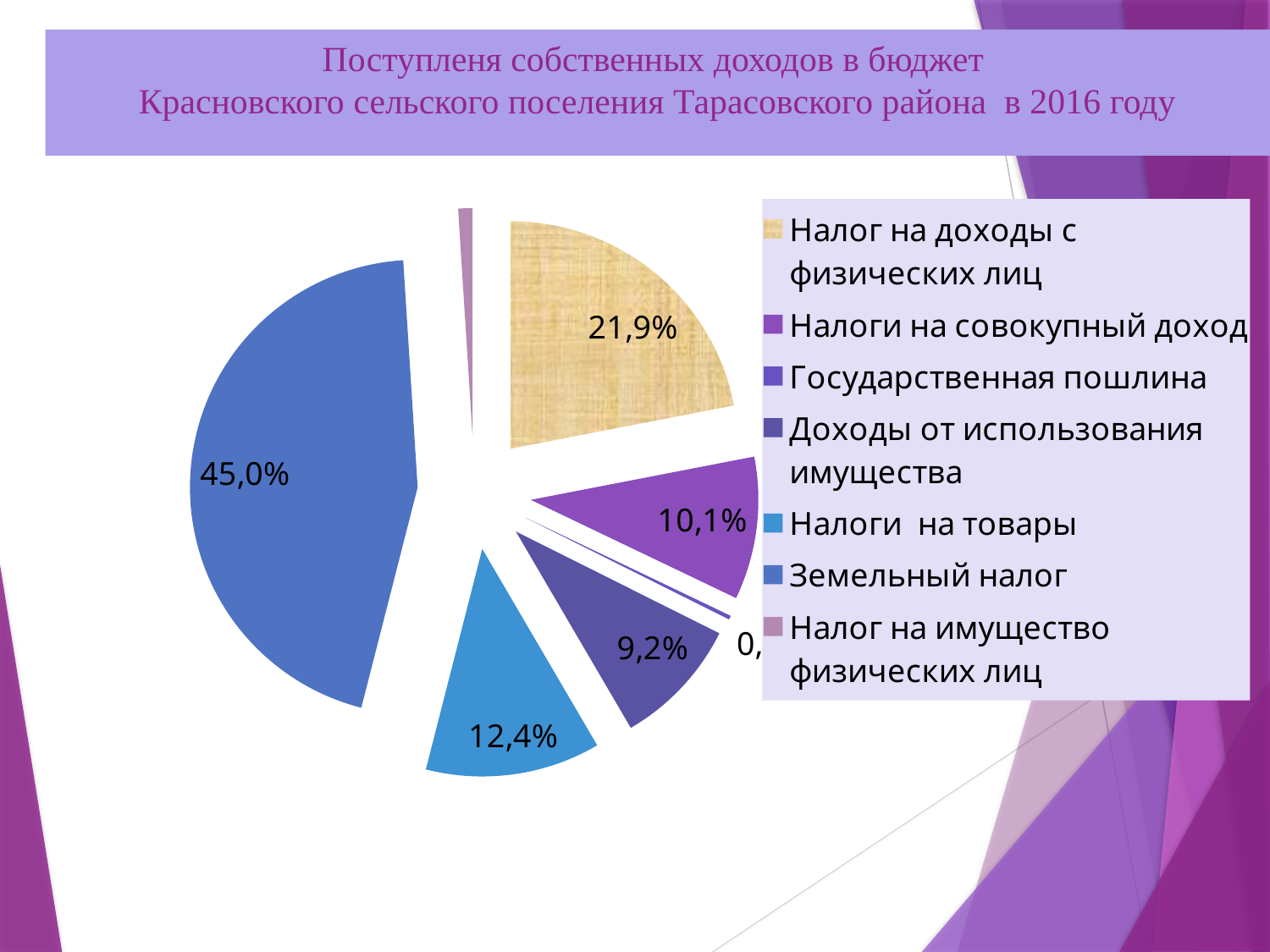
What is the difference between the shares of Налоги на товары and Налоги на совокупный доход? 2,3% How many categories does the legend list? 7 Which year does the chart title refer to? 2016 What percentage is shown for Налоги на совокупный доход? 10,1% What share is labelled for Доходы от использования имущества? 9,2% What is the difference between the shares of Земельный налог and Налог на доходы с физических лиц? 23,1% Which category has the largest slice of the pie? Земельный налог What percentage is shown for Налог на доходы с физических лиц? 21,9% What type of chart is shown on the slide? Pie chart What share of the pie does Земельный налог account for? 45,0% Which is larger: the share of Налоги на товары or the share of Доходы от использования имущества? Налоги на товары What is the value labelled for Налоги на товары? 12,4%